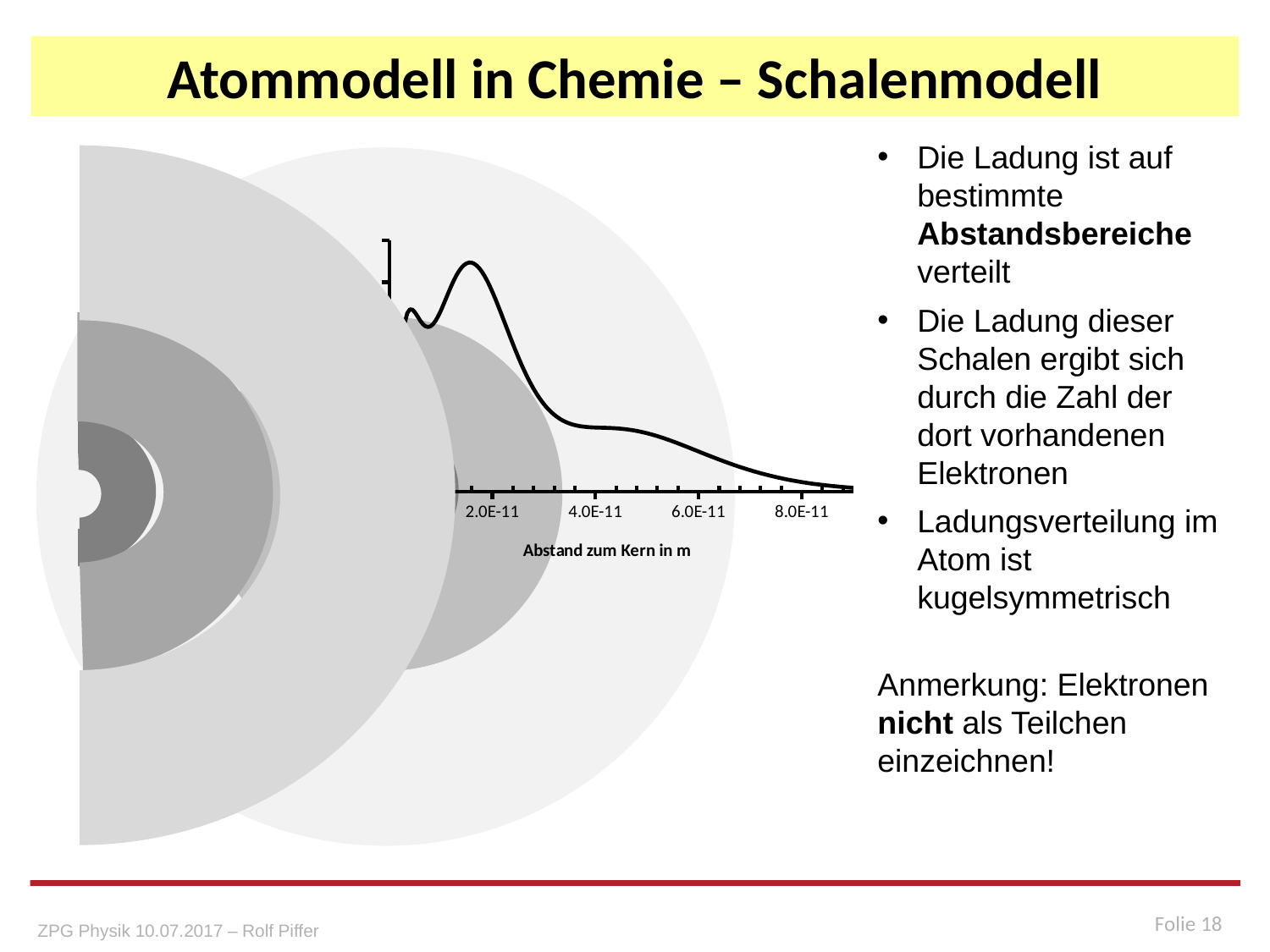
How many curves (series) are plotted in the chart? 1 Is the highest point of the curve located at a distance greater or less than 4.0E-11 on the x axis? less What is the largest labelled tick value on the x axis of the chart? 8.0E-11 What is the title of the x axis of the chart? Abstand zum Kern in m How many labelled tick values are shown on the x axis of the chart? 4 Is the value of the curve at 2.0E-11 larger or smaller than its value at 6.0E-11? larger Between 2.0E-11 and 8.0E-11 on the x axis, does the curve rise or fall overall? fall What kind of chart is overlaid on the shell diagram on the left of the slide? line chart